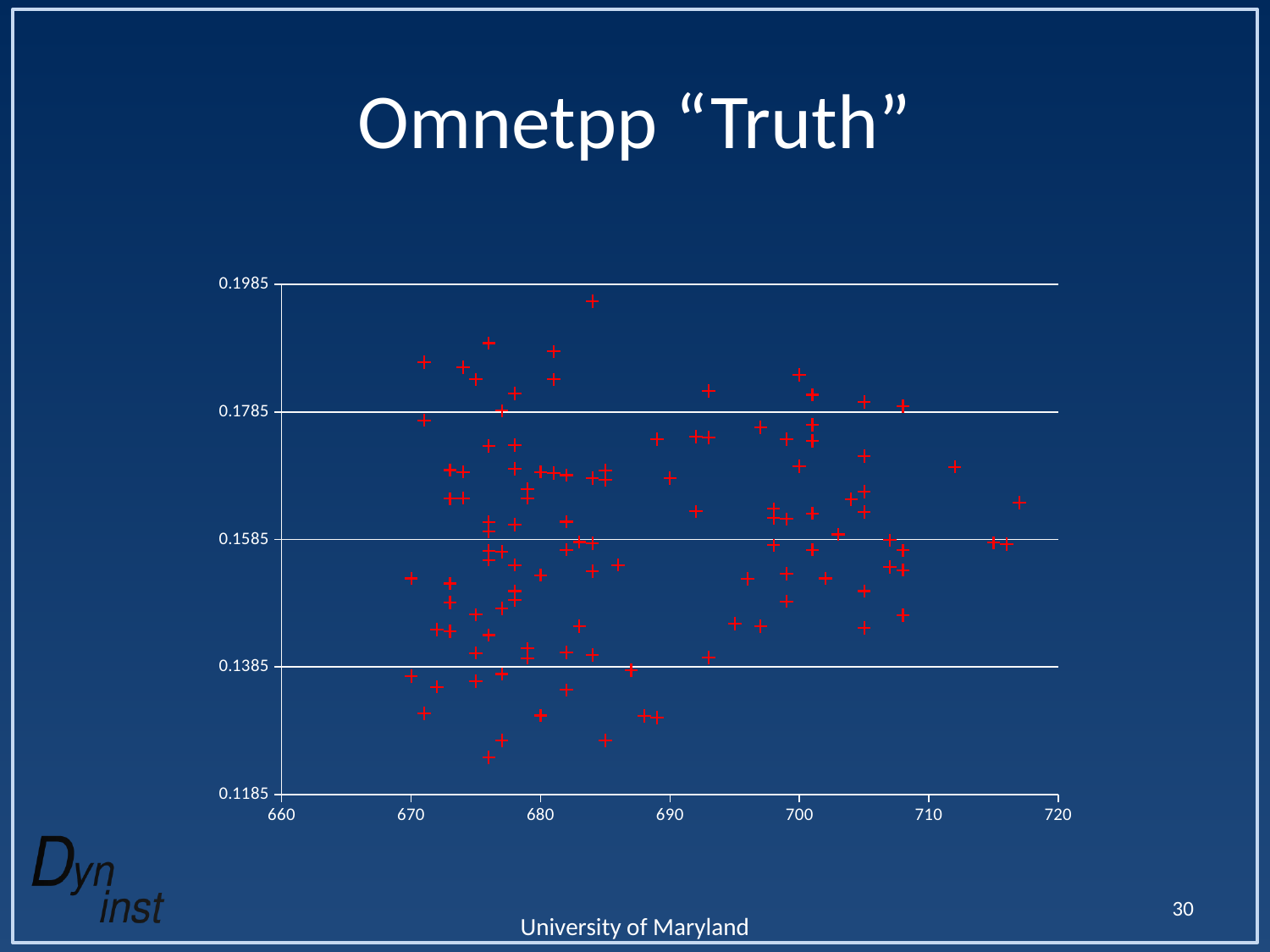
Is the y value of the highest point in the chart greater or less than 0.1985? less Is the x value of the rightmost point in the chart greater or less than 710? greater Is the x value of the rightmost point in the chart greater or less than 720? less What kind of chart is shown on the slide? scatter chart What colour are the data point markers in the chart? red What is the title of the chart? Omnetpp "Truth"